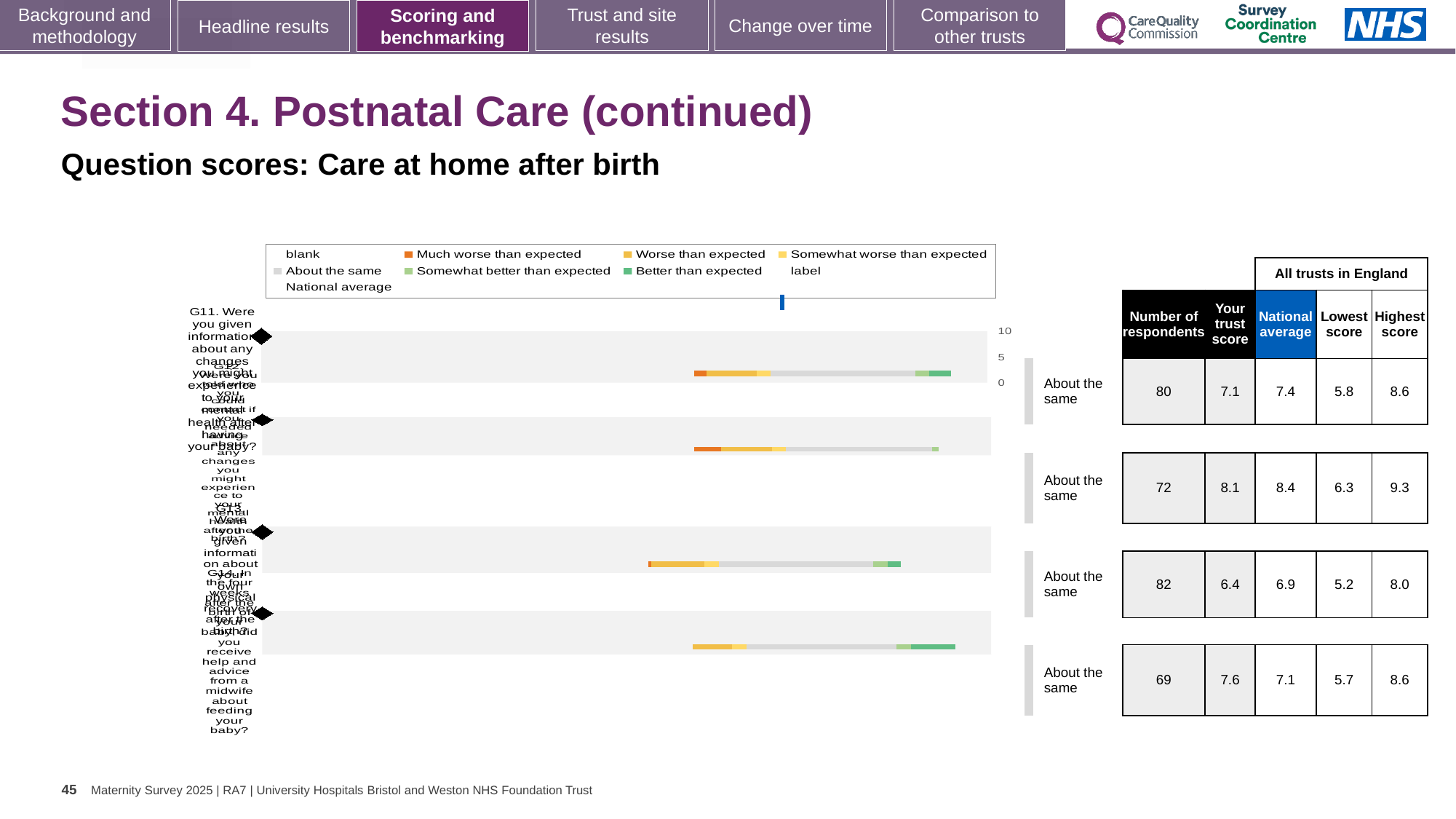
In the table, what is the highest score for the fourth row? 8.6 In the chart legend, what colour represents 'Better than expected'? green Which row of the table has the lowest 'Lowest score'? the third row (5.2) How many question rows (bars) does the chart show? 4 In the fourth row of the table, which is larger: the trust score or the national average? the trust score (7.6) In the second row of the table, what is the difference between the national average and the trust score? 0.3 What kind of chart is shown on the slide? bar chart In the table, what is the national average for the third row? 6.9 In the table, what is the 'Your trust score' for the second row? 8.1 In the table, what is the number of respondents for the first row? 80 In the chart legend, what colour represents 'Much worse than expected'? orange Which row of the table has the highest 'Your trust score'? the second row (8.1)